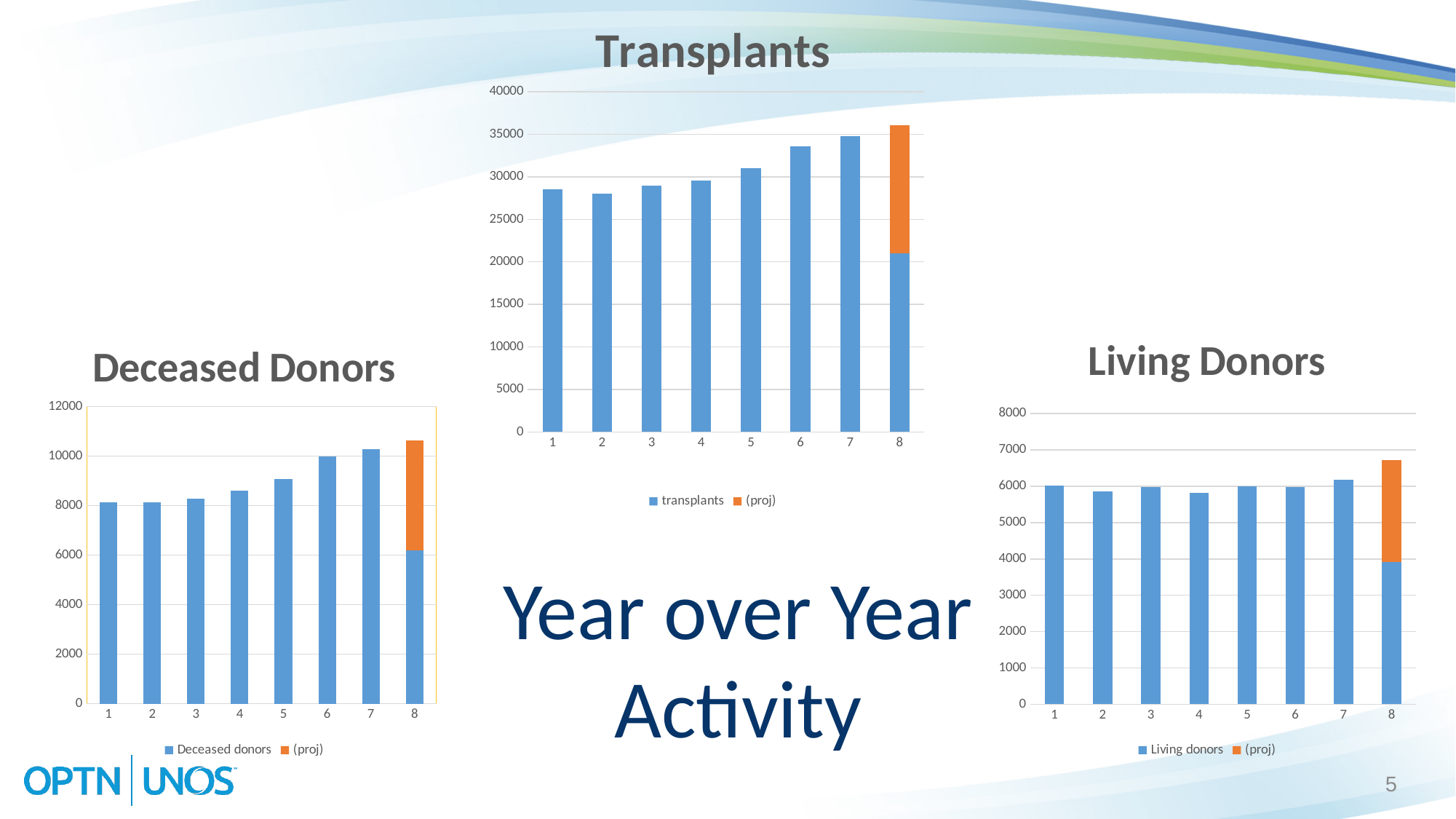
In the Transplants chart, do the values generally rise or fall from category 1 to category 7? rise In the Deceased Donors chart, is the value for category 7 greater or less than 10000? greater In the Transplants chart, which of categories 3 and 6 has the larger value? 6 In the Deceased Donors chart, which of categories 1 to 7 has the highest value? 7 What type of chart is the Transplants chart? bar chart How many categories are shown on the x axis of the Deceased Donors chart? 8 What are the two legend entries of the Deceased Donors chart? Deceased donors and (proj) How many series does the legend of the Living Donors chart list? 2 In the Transplants chart, is the blue transplants value for category 8 greater or less than 25000? less In the Transplants chart, is the value for category 7 greater or less than 30000? greater